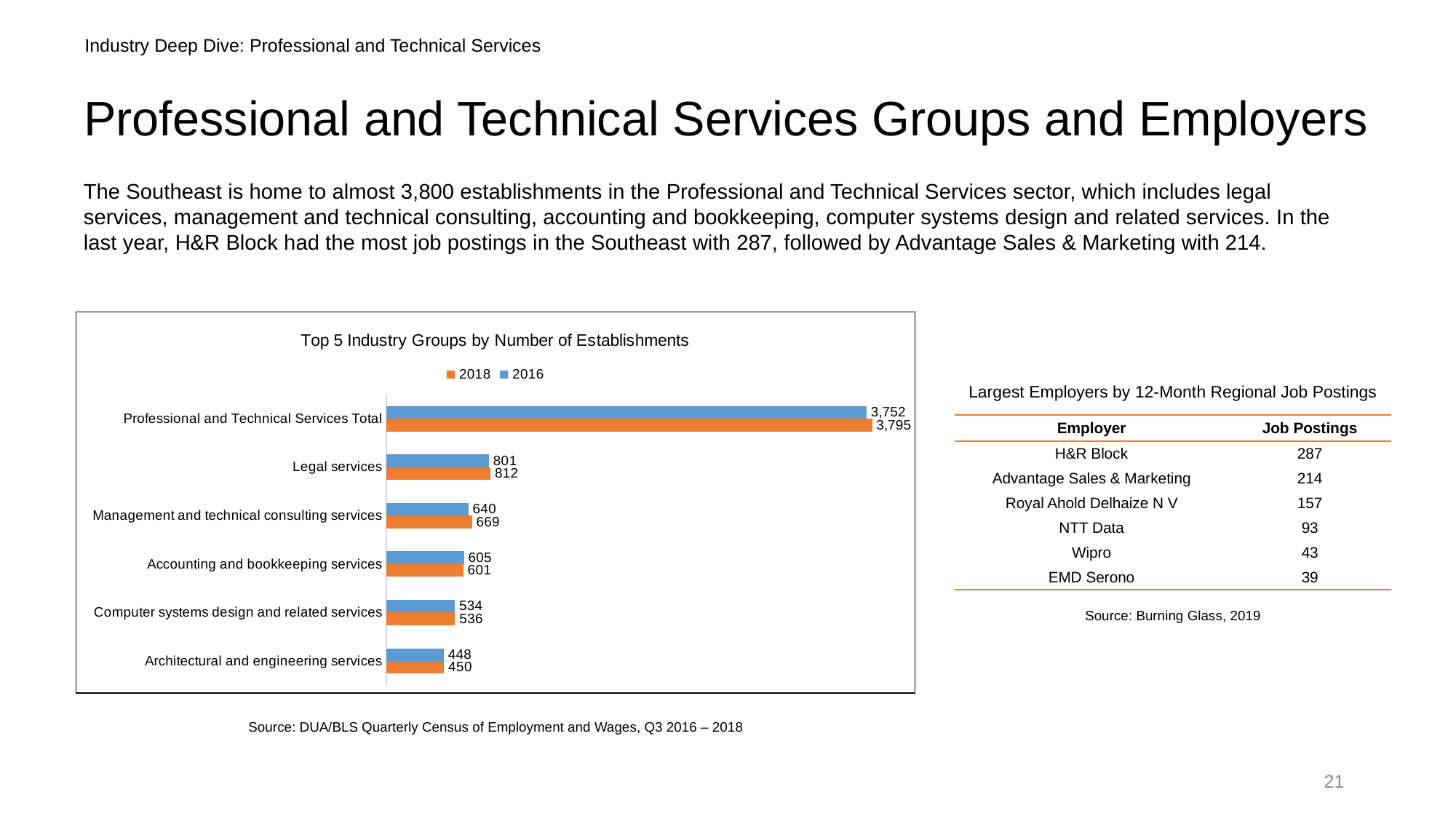
What is the 2018 value for Legal services? 812 How many categories are shown on the chart? 6 What colour represents the 2018 series in the chart? orange How many series does the legend of the chart list? 2 What is the 2018 value for Professional and Technical Services Total? 3,795 What is the 2016 value for Management and technical consulting services? 640 What is the difference between the 2018 and 2016 values for Management and technical consulting services? 29 What is the 2016 value for Architectural and engineering services? 448 What type of chart is shown on the slide? bar chart Which industry group has the lowest number of establishments in 2016? Architectural and engineering services Which is larger for Accounting and bookkeeping services, the 2016 value or the 2018 value? 2016 Excluding the total, which industry group has the highest number of establishments in 2018? Legal services